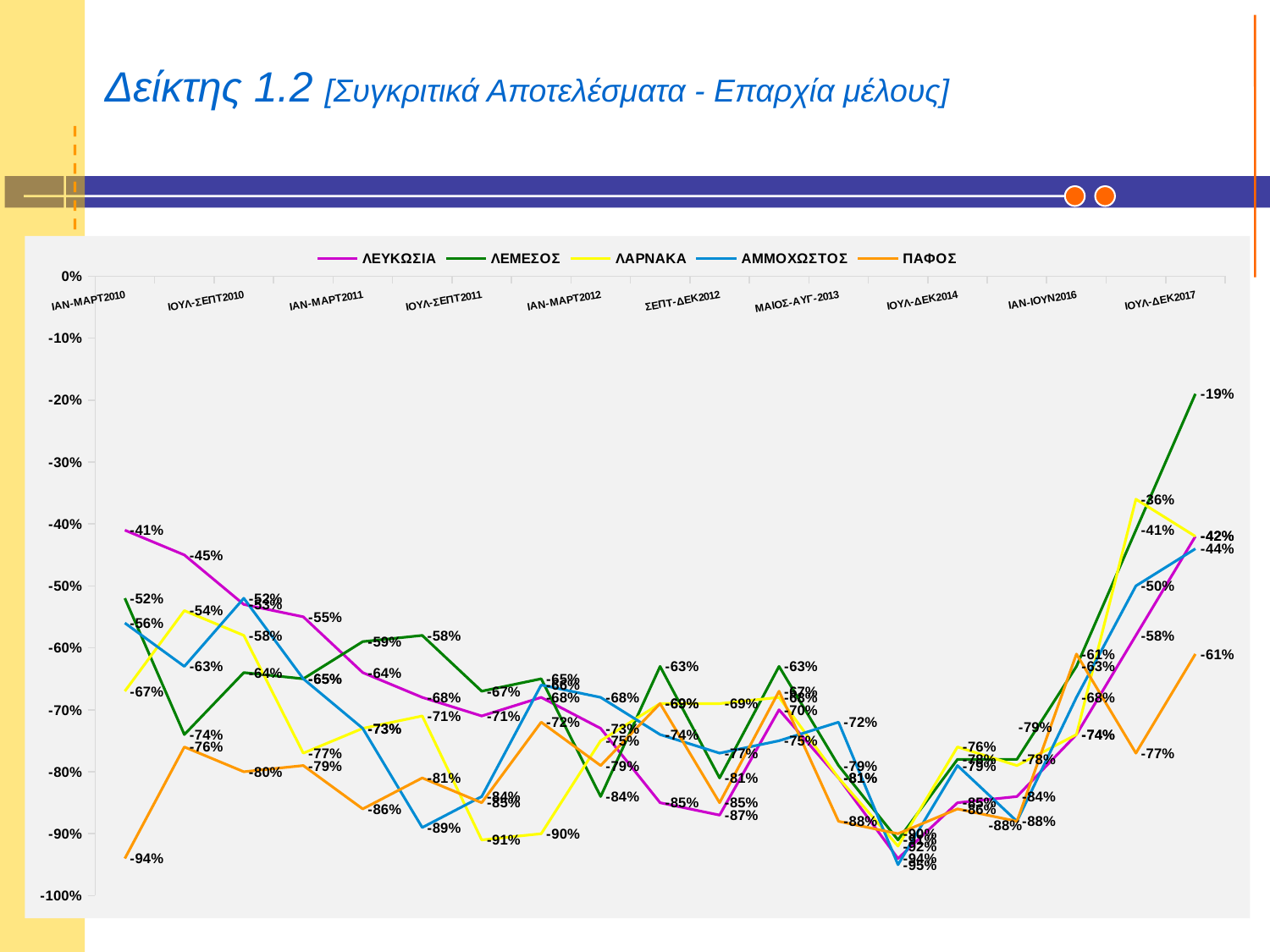
What is the value for ΠΑΦΟΣ at ΙΑΝ-ΜΑΡΤ2010? -94% What is the value for ΛΕΥΚΩΣΙΑ at ΙΑΝ-ΜΑΡΤ2010? -41% What is the difference between the ΛΕΥΚΩΣΙΑ and ΠΑΦΟΣ values at ΙΑΝ-ΜΑΡΤ2010? 53 percentage points At the last point on the chart, is the value for ΛΕΜΕΣΟΣ greater or less than -30%? greater What kind of chart is shown on the slide? line chart How many series does the legend list? 5 What is the value for ΛΕΜΕΣΟΣ at the last point on the chart? -19% Does the ΠΑΦΟΣ line overall rise or fall from its first point to its last point? rise Which series has the lowest value at ΙΑΝ-ΜΑΡΤ2010? ΠΑΦΟΣ Which series has the highest value at ΙΑΝ-ΜΑΡΤ2010? ΛΕΥΚΩΣΙΑ What colour is the ΠΑΦΟΣ line in the legend? orange What is the value for ΠΑΦΟΣ at the last point on the chart? -61%